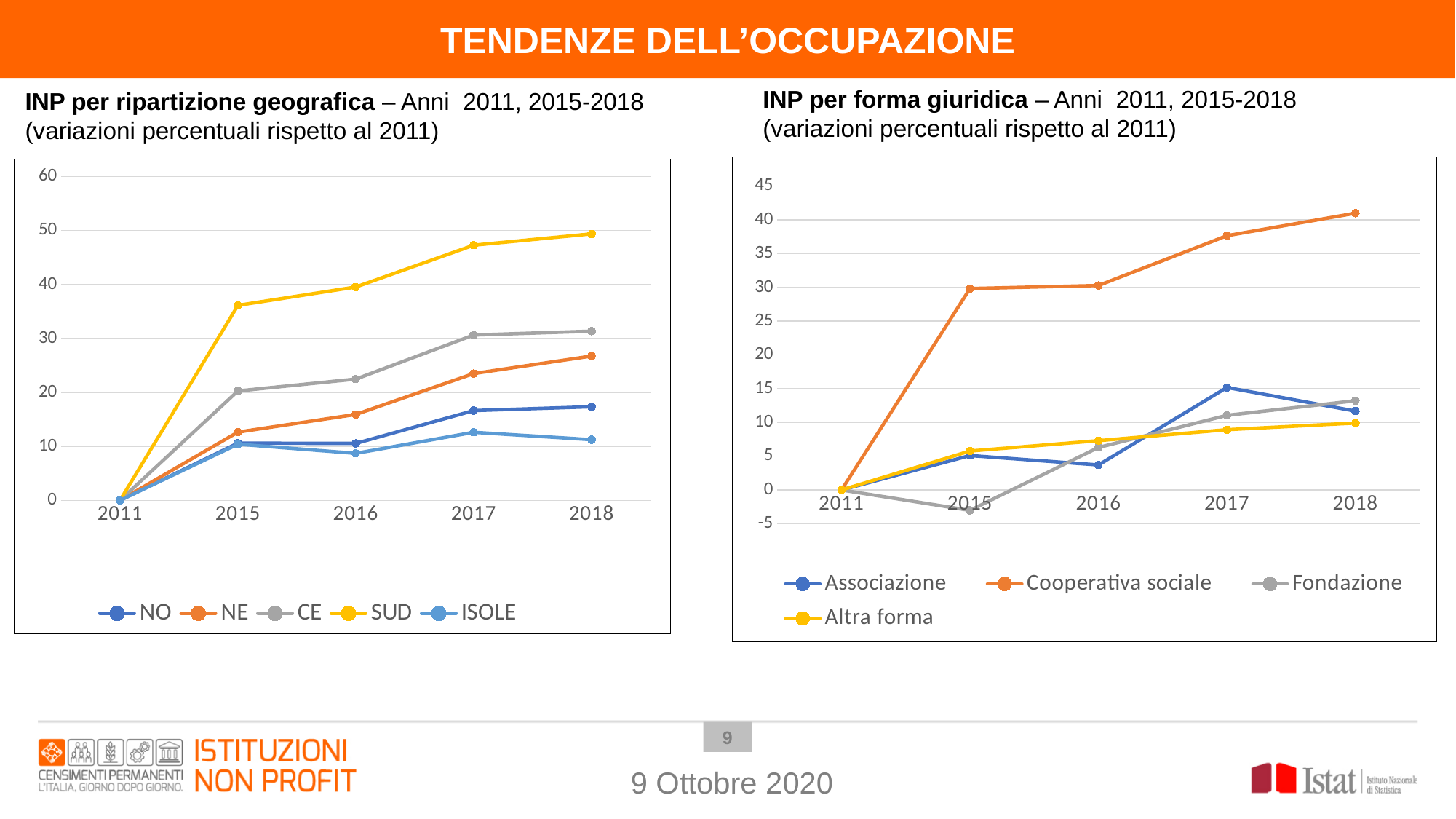
In the 'INP per ripartizione geografica' chart, which series has the highest value in 2018? SUD How many series does the legend of the 'INP per ripartizione geografica' chart list? 5 In the 'INP per forma giuridica' chart, is the value for Fondazione in 2015 greater or less than 0? less In the 'INP per forma giuridica' chart, does the Cooperativa sociale series rise or fall from 2011 to 2018? rise In the 'INP per ripartizione geografica' chart, is the value for SUD in 2015 greater or less than 30? greater In the 'INP per forma giuridica' chart, which series has the lowest value in 2015? Fondazione In the 'INP per ripartizione geografica' chart, is the value for NE in 2018 greater or less than 30? less What kind of chart is the 'INP per ripartizione geografica' chart on the left? line chart In the 'INP per ripartizione geografica' chart, which series has the lowest value in 2018? ISOLE In the 'INP per forma giuridica' chart, which series has the highest value in 2018? Cooperativa sociale How many years are shown on the x axis of the 'INP per forma giuridica' chart? 5 In the 'INP per ripartizione geografica' chart, what is the value for all series in 2011? 0